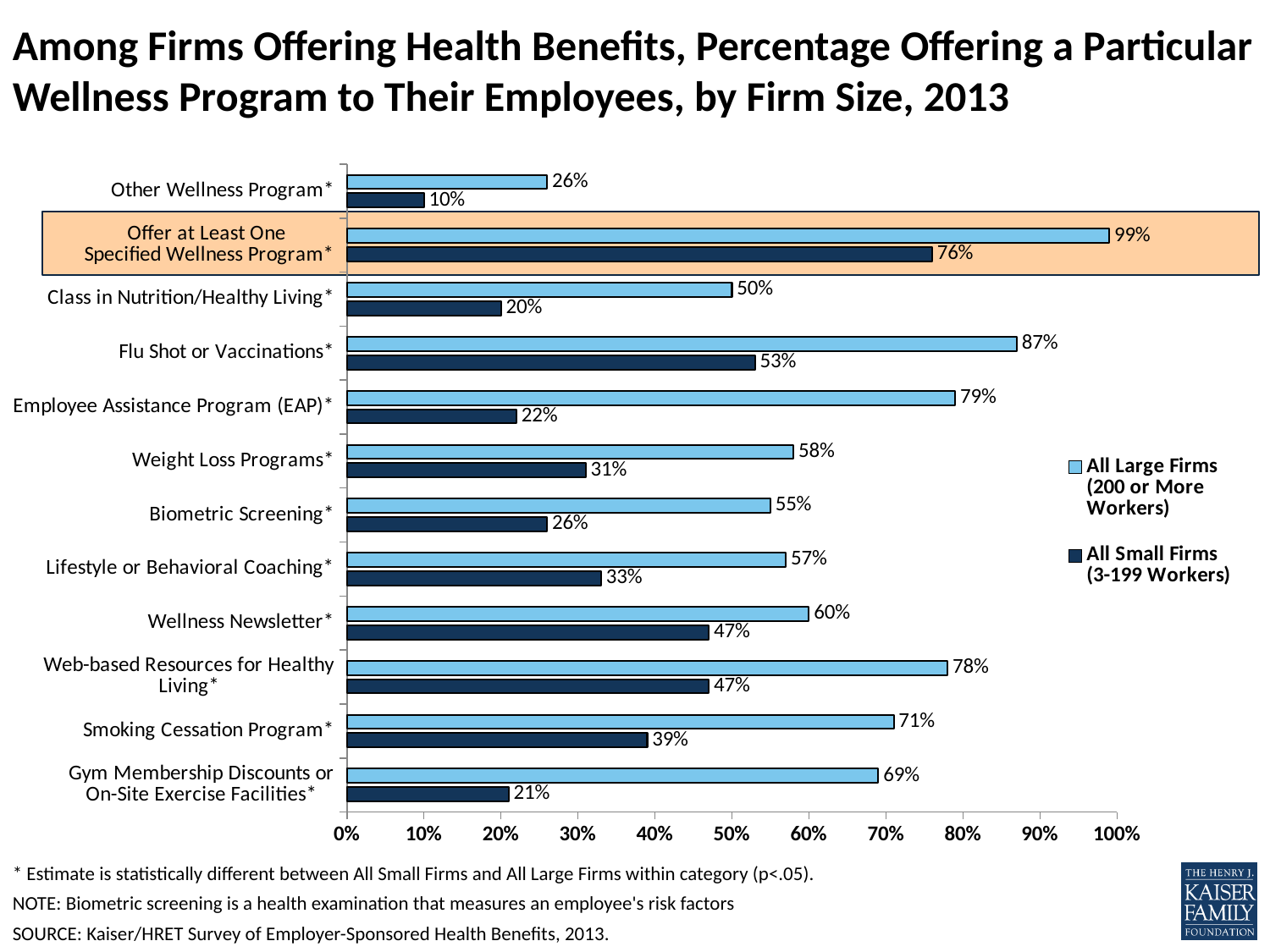
Which is larger: the All Small Firms value for Wellness Newsletter or the All Small Firms value for Weight Loss Programs? Wellness Newsletter What is the difference between All Large Firms and All Small Firms for Gym Membership Discounts or On-Site Exercise Facilities? 48 percentage points What percentage of All Large Firms (200 or More Workers) offer a Flu Shot or Vaccinations? 87% Is the All Large Firms value for Biometric Screening greater or less than 50%? greater Which category has the highest value for All Large Firms (200 or More Workers)? Offer at Least One Specified Wellness Program How many series does the legend list? 2 Which category is highlighted with an orange box on the chart? Offer at Least One Specified Wellness Program What percentage of All Small Firms (3-199 Workers) offer a Smoking Cessation Program? 39% What kind of chart is shown on the slide? Bar chart How many wellness program categories are shown on the chart? 12 Which category has the lowest value for All Small Firms (3-199 Workers)? Other Wellness Program What percentage of All Small Firms (3-199 Workers) offer an Employee Assistance Program (EAP)? 22%